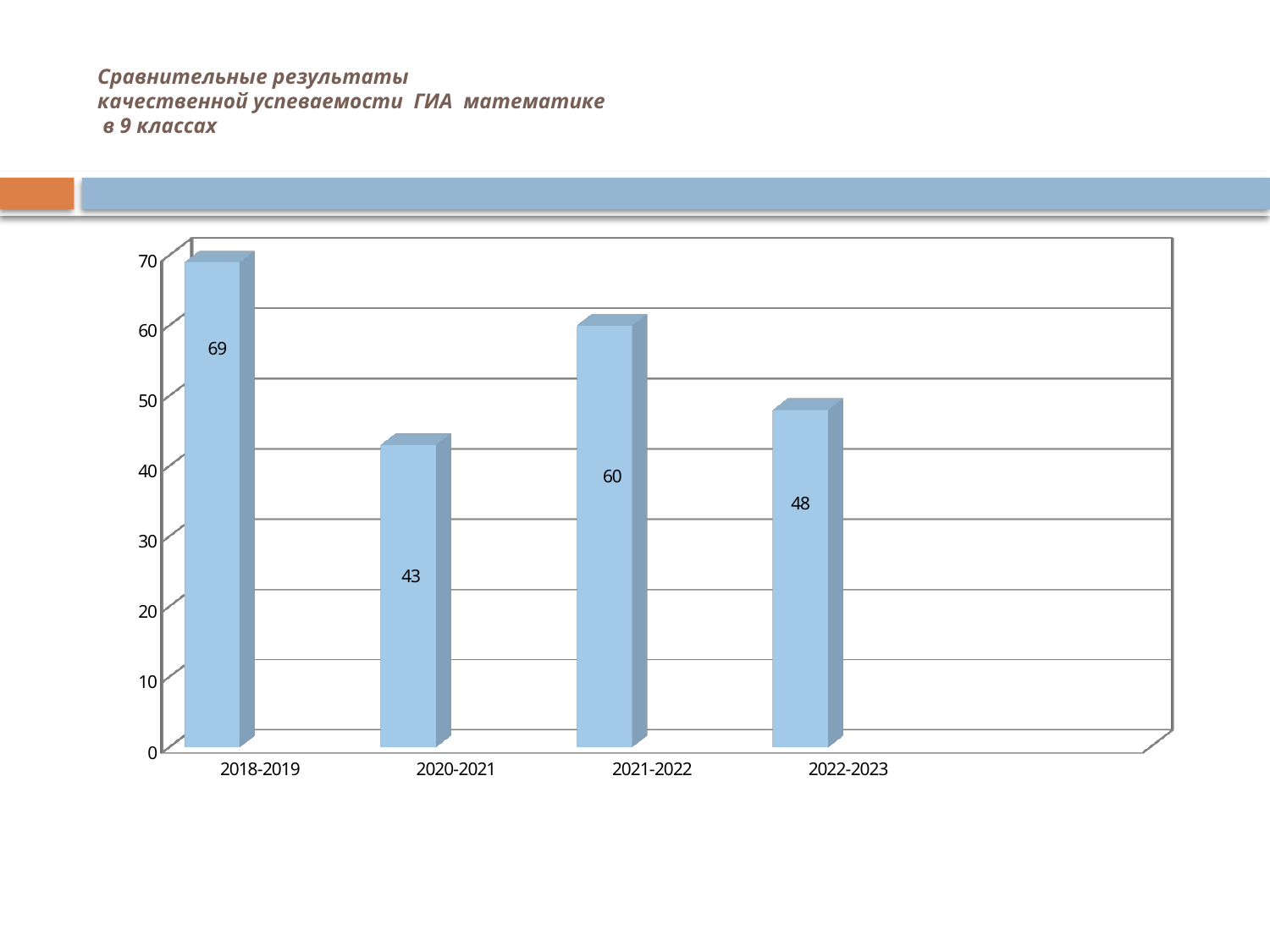
What is the value for 2020-2021? 43 How many academic years are shown on the x axis? 4 Which academic year has the lowest value? 2020-2021 Is the value for 2022-2023 greater or less than 50? less What is the value for 2018-2019? 69 What is the difference between the values for 2018-2019 and 2020-2021? 26 What is the value for 2021-2022? 60 What is the value for 2022-2023? 48 What is the difference between the values for 2021-2022 and 2022-2023? 12 What kind of chart is shown on the slide? bar chart Which academic year has the highest value? 2018-2019 Which is larger, the value for 2021-2022 or the value for 2022-2023? 2021-2022